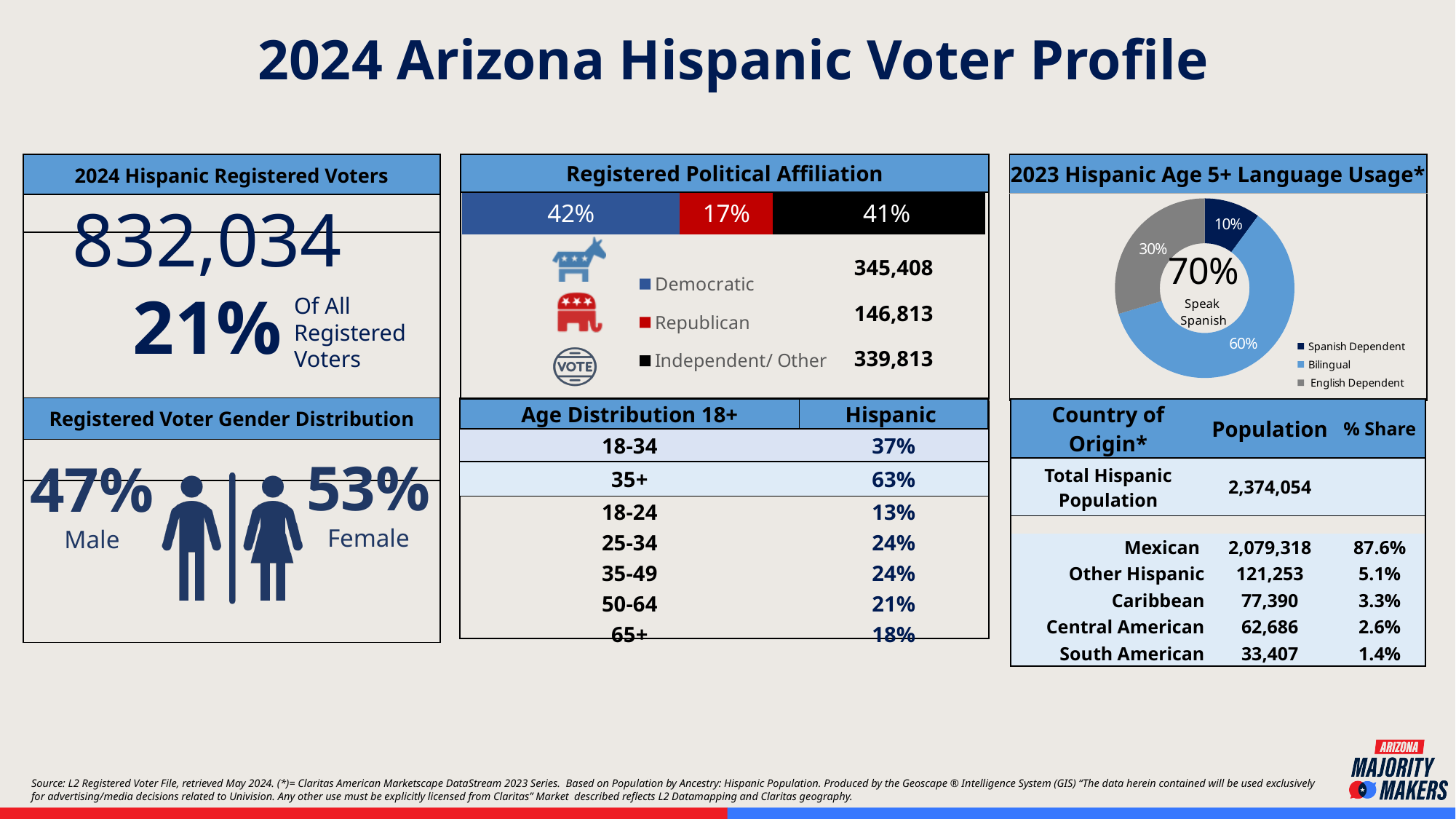
On the Registered Political Affiliation chart, what is the difference in percentage points between Democratic and Republican? 25 On the Registered Political Affiliation bar, what percentage is Republican? 17% On the Registered Political Affiliation bar, what percentage is Independent/ Other? 41% On the 2023 Hispanic Age 5+ Language Usage chart, which category has the largest share? Bilingual On the Registered Political Affiliation bar, what percentage is Democratic? 42% On the 2023 Hispanic Age 5+ Language Usage chart, which category has the smallest share? Spanish Dependent On the 2023 Hispanic Age 5+ Language Usage chart, how many categories does the legend list? 3 On the Registered Political Affiliation chart, which affiliation has the smallest share? Republican What kind of chart is the 2023 Hispanic Age 5+ Language Usage chart? Donut (pie) chart On the 2023 Hispanic Age 5+ Language Usage chart, what share is Bilingual? 60% On the 2023 Hispanic Age 5+ Language Usage chart, what share is Spanish Dependent? 10% On the 2023 Hispanic Age 5+ Language Usage chart, what share is English Dependent? 30%